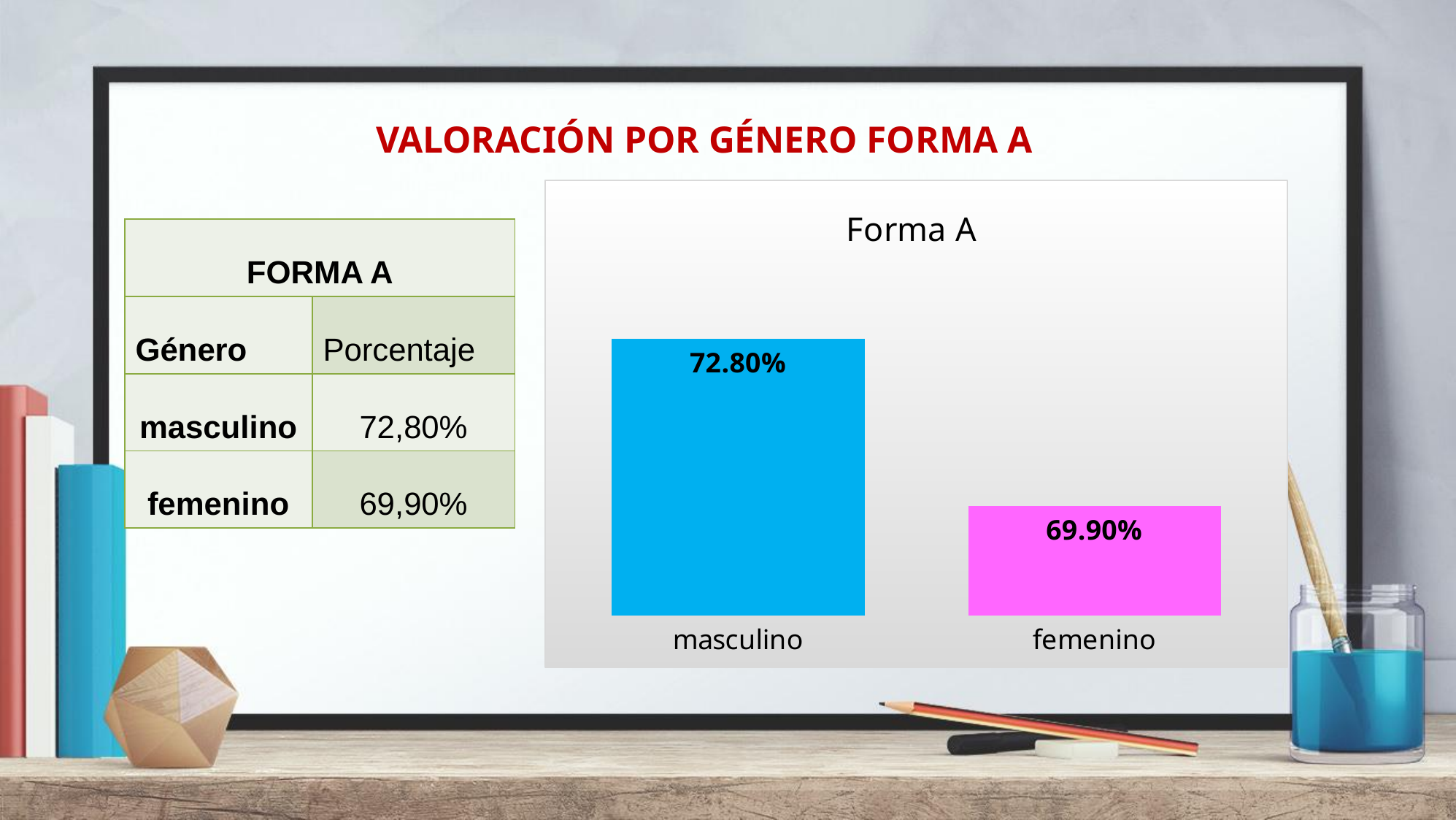
What is the title of the chart? Forma A Which is larger in the Forma A chart, masculino or femenino? masculino What is the difference between the masculino and femenino values in the Forma A chart? 2.90% What is the value for femenino in the Forma A chart? 69.90% How many categories are shown in the Forma A chart? 2 What kind of chart is shown on the slide? bar chart Which category has the lowest value in the Forma A chart? femenino What colour is the masculino bar in the Forma A chart? blue Which category has the highest value in the Forma A chart? masculino Do the values rise or fall from masculino to femenino in the Forma A chart? fall What is the value for masculino in the Forma A chart? 72.80%